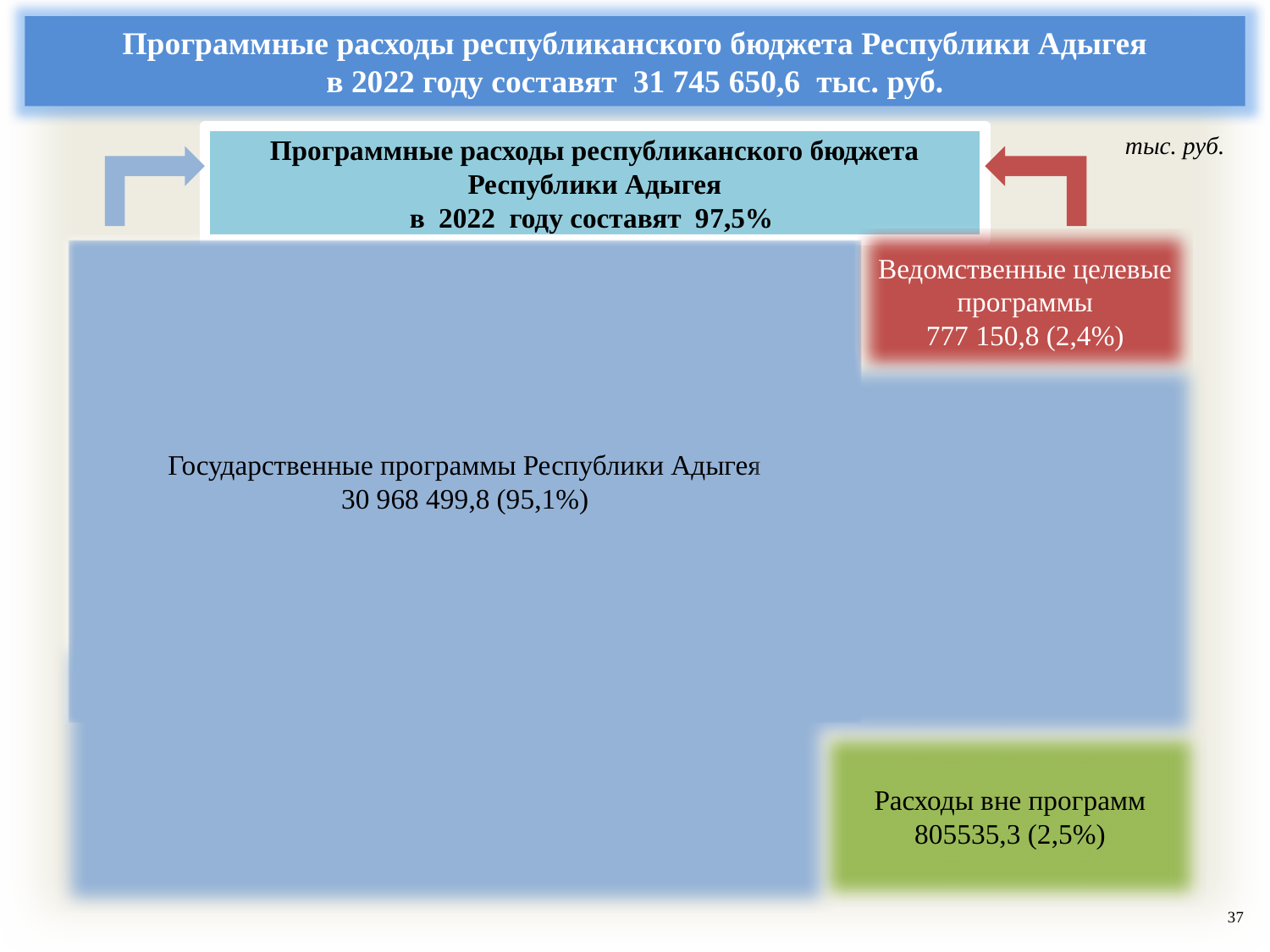
What share of the total do Расходы вне программ represent? 2,5% What is the difference between the values for Расходы вне программ and Ведомственные целевые программы? 28 384,5 Which category has the highest value? Государственные программы Республики Адыгея What is the value for Ведомственные целевые программы? 777 150,8 What is the value for Государственные программы Республики Адыгея? 30 968 499,8 Which category has the lowest value? Ведомственные целевые программы Which is larger: Расходы вне программ or Ведомственные целевые программы? Расходы вне программ What is the value for Расходы вне программ? 805535,3 How many categories are shown in the chart? 3 What share of the total do Государственные программы Республики Адыгея represent? 95,1% What colour is the block for Расходы вне программ? green What kind of chart is shown on the slide? treemap